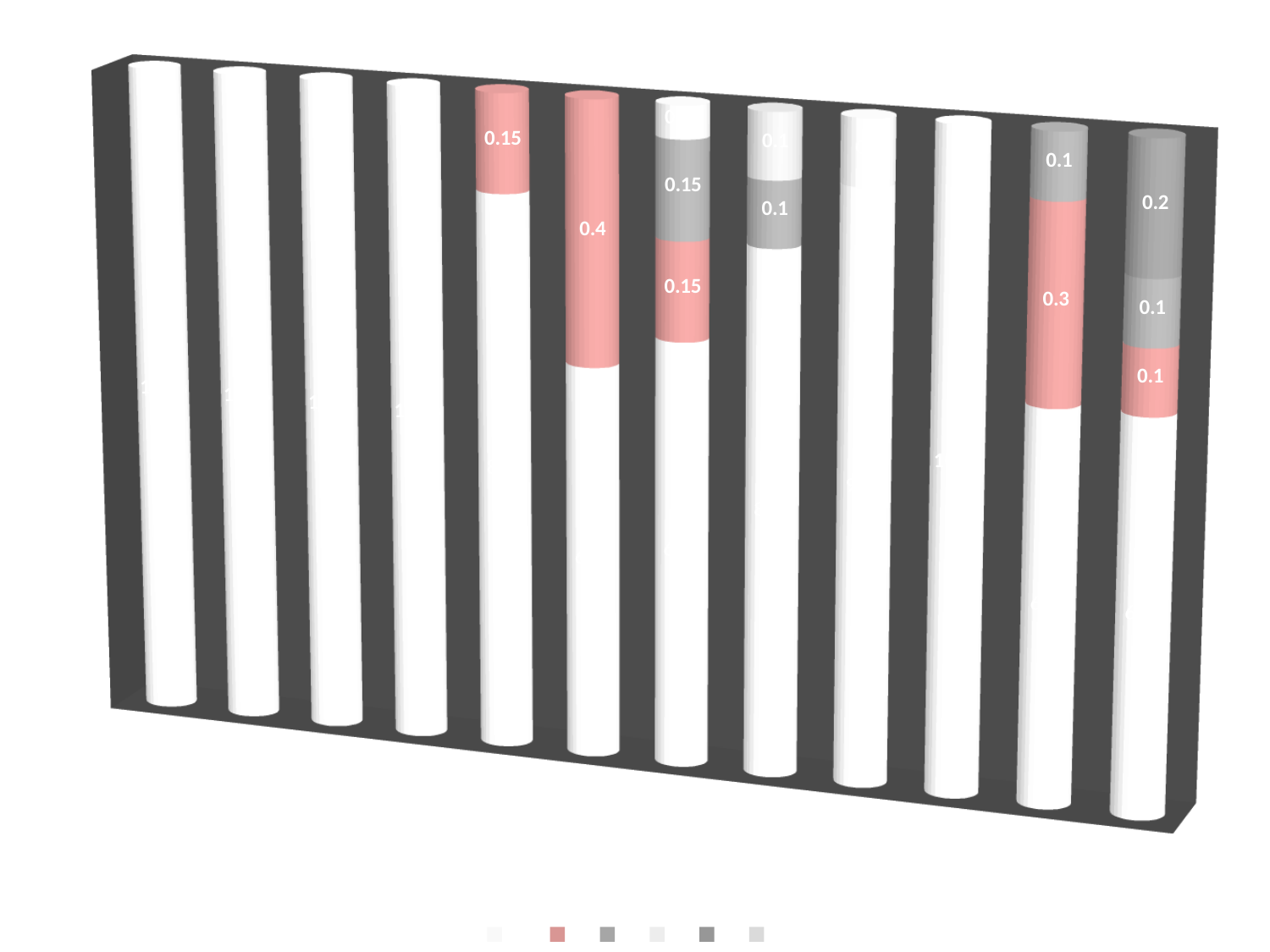
How many series does the legend list? 6 What is the value of the pink segment in the sixth bar from the left? 0.4 What is the difference between the pink segment of the sixth bar (0.4) and the pink segment of the fifth bar (0.15)? 0.25 What is the value of the topmost grey segment in the rightmost bar? 0.2 What is the value of the pink segment in the eleventh bar from the left? 0.3 What is the value of the pink segment in the rightmost bar? 0.1 What is the value of the pink segment in the fifth bar from the left? 0.15 How many bars are plotted in the chart? 12 Is the pink segment larger in the fifth bar or the sixth bar from the left? the sixth bar What colour is the segment labelled 0.4? pink Which bar has the largest pink segment? the sixth bar from the left What kind of chart is shown on the slide? bar chart